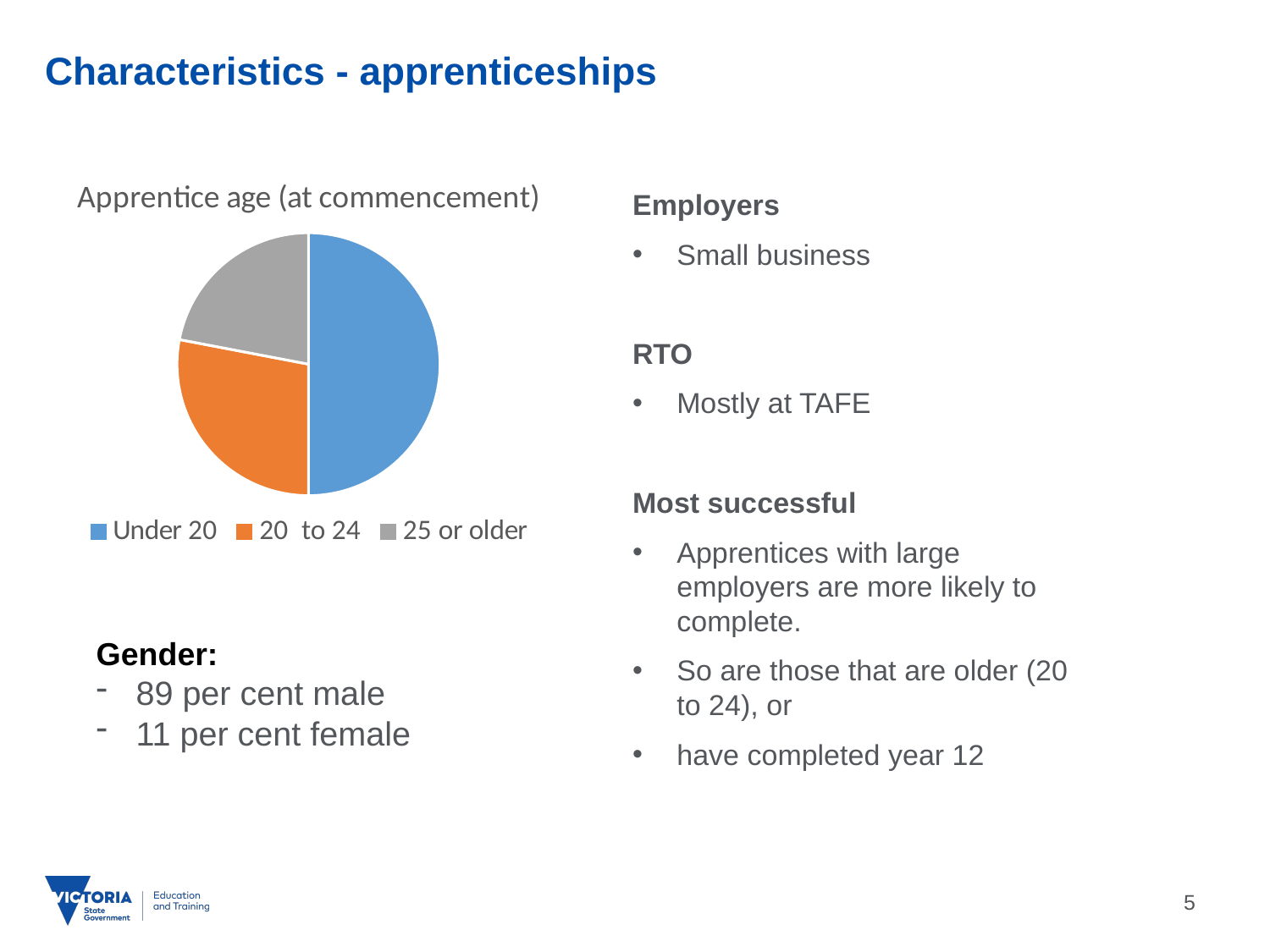
Which age category is shown in orange in the pie chart? 20 to 24 Which colour represents the Under 20 category in the pie chart? blue How many age categories does the pie chart show? 3 Which age category has the smallest slice of the pie chart? 25 or older Which age category has the largest slice of the pie chart? Under 20 What is the title of the pie chart? Apprentice age (at commencement) Which slice is larger in the pie chart, Under 20 or 20 to 24? Under 20 What kind of chart is shown on the slide? pie chart Which slice is larger in the pie chart, 20 to 24 or 25 or older? 20 to 24